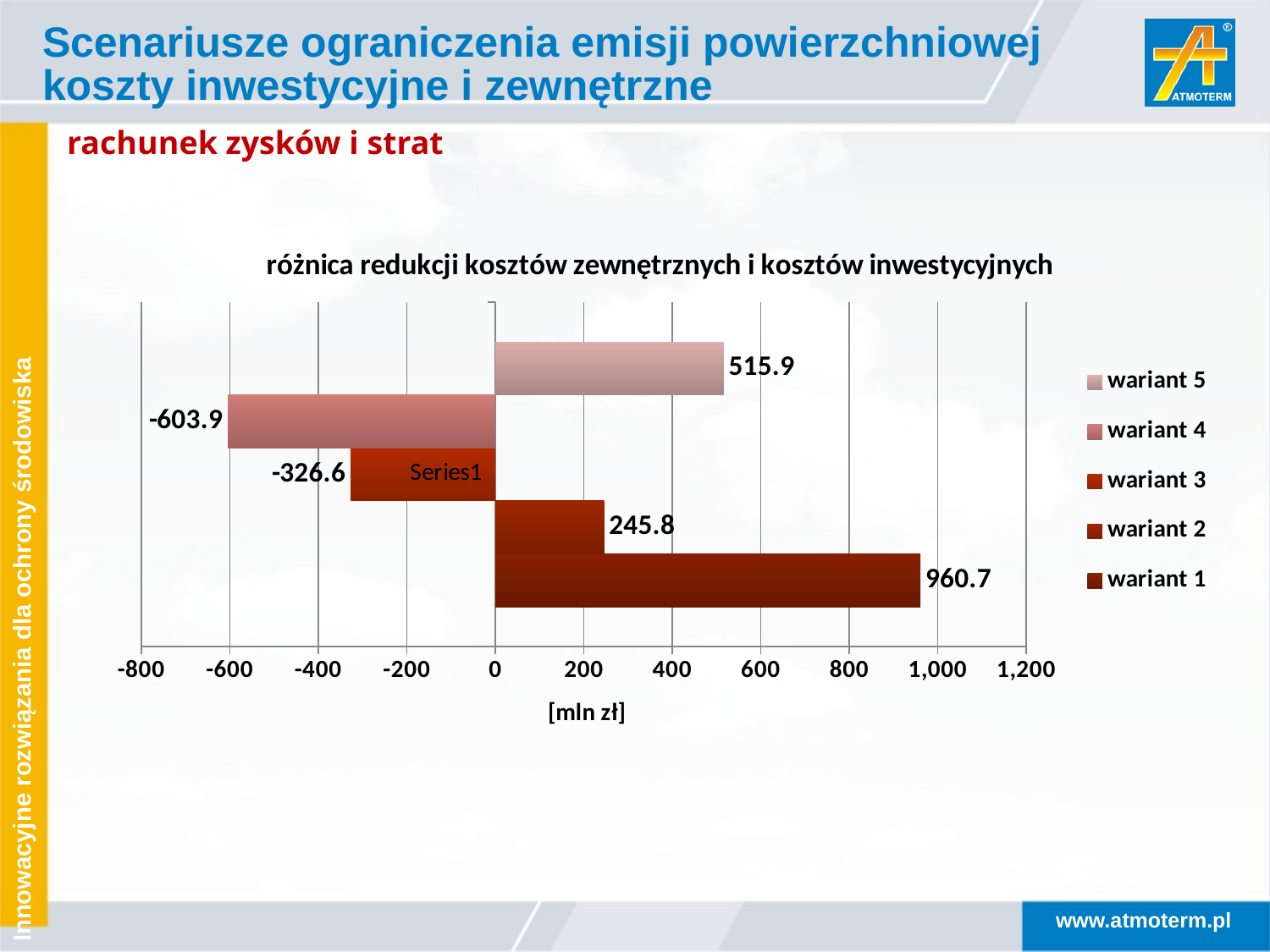
Which wariant has the highest value? wariant 1 What is the value for wariant 1? 960.7 What unit is shown on the horizontal axis of the chart? [mln zł] What type of chart is shown on the slide? bar chart What is the title of the chart? różnica redukcji kosztów zewnętrznych i kosztów inwestycyjnych Which is larger, the value for wariant 2 or the value for wariant 5? wariant 5 How many series does the legend list? 5 What is the value for wariant 4? -603.9 What is the difference between the values for wariant 1 and wariant 5? 444.8 What is the value for wariant 5? 515.9 Which wariant has the lowest value? wariant 4 What is the value for wariant 3? -326.6